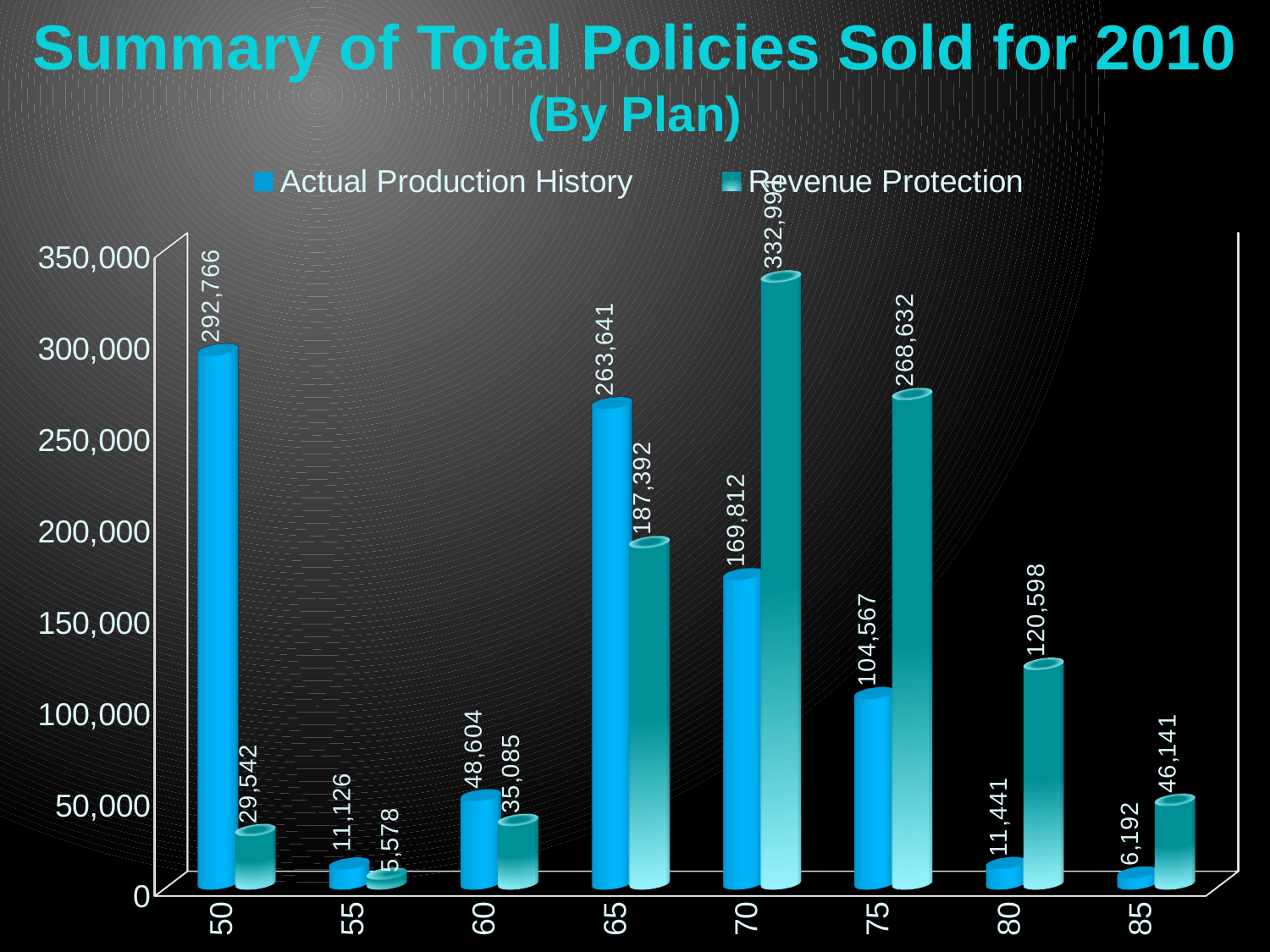
How many plan categories are shown on the x axis? 8 What is the Revenue Protection value for plan 75? 268,632 What is the Revenue Protection value for plan 80? 120,598 Which plan has the highest Actual Production History value? 50 What is the difference between Actual Production History and Revenue Protection for plan 65? 76,249 Which plan has the lowest Actual Production History value? 85 Which plan has the lowest Revenue Protection value? 55 What is the Actual Production History value for plan 65? 263,641 How many series does the legend list? 2 Is the Revenue Protection value for plan 70 greater or less than 300,000? greater For plan 75, which series has the larger value: Actual Production History or Revenue Protection? Revenue Protection What is the Actual Production History value for plan 50? 292,766